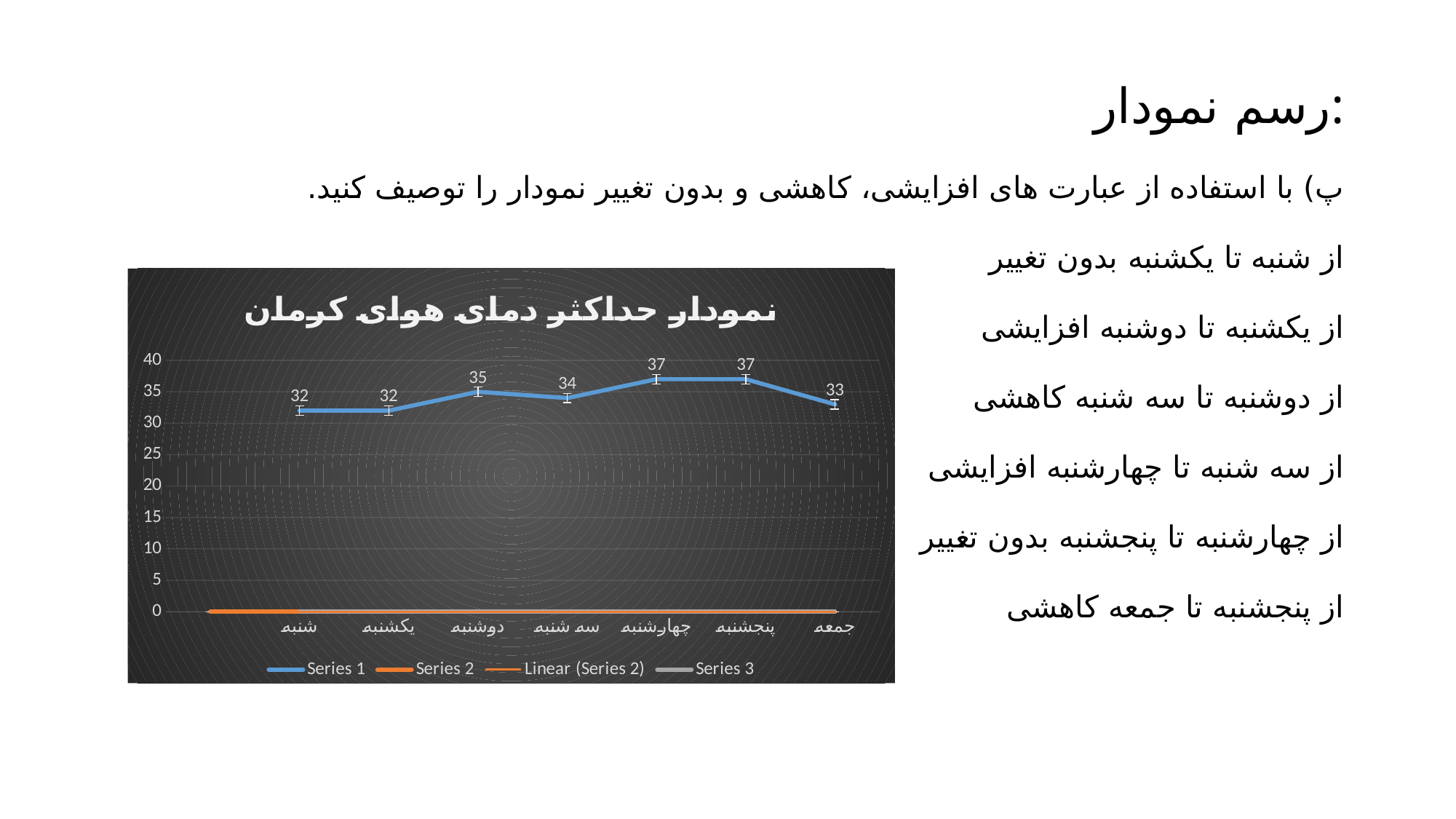
What is the title of the chart? نمودار حداکثر دمای هوای کرمان What is the difference between the values for چهارشنبه and جمعه in Series 1? 4 What is the value for دوشنبه in Series 1? 35 Does Series 1 rise or fall from پنجشنبه to جمعه? fall What is the value for سه شنبه in Series 1? 34 Which is larger in Series 1, the value for دوشنبه or the value for سه شنبه? دوشنبه What is the value for جمعه in Series 1? 33 What is the highest value shown in Series 1? 37 How many days are shown on the x axis? 7 What type of chart is shown on the slide? line chart Which day has the lowest value in Series 1? شنبه and یکشنبه (both 32) How many entries does the legend list? 4